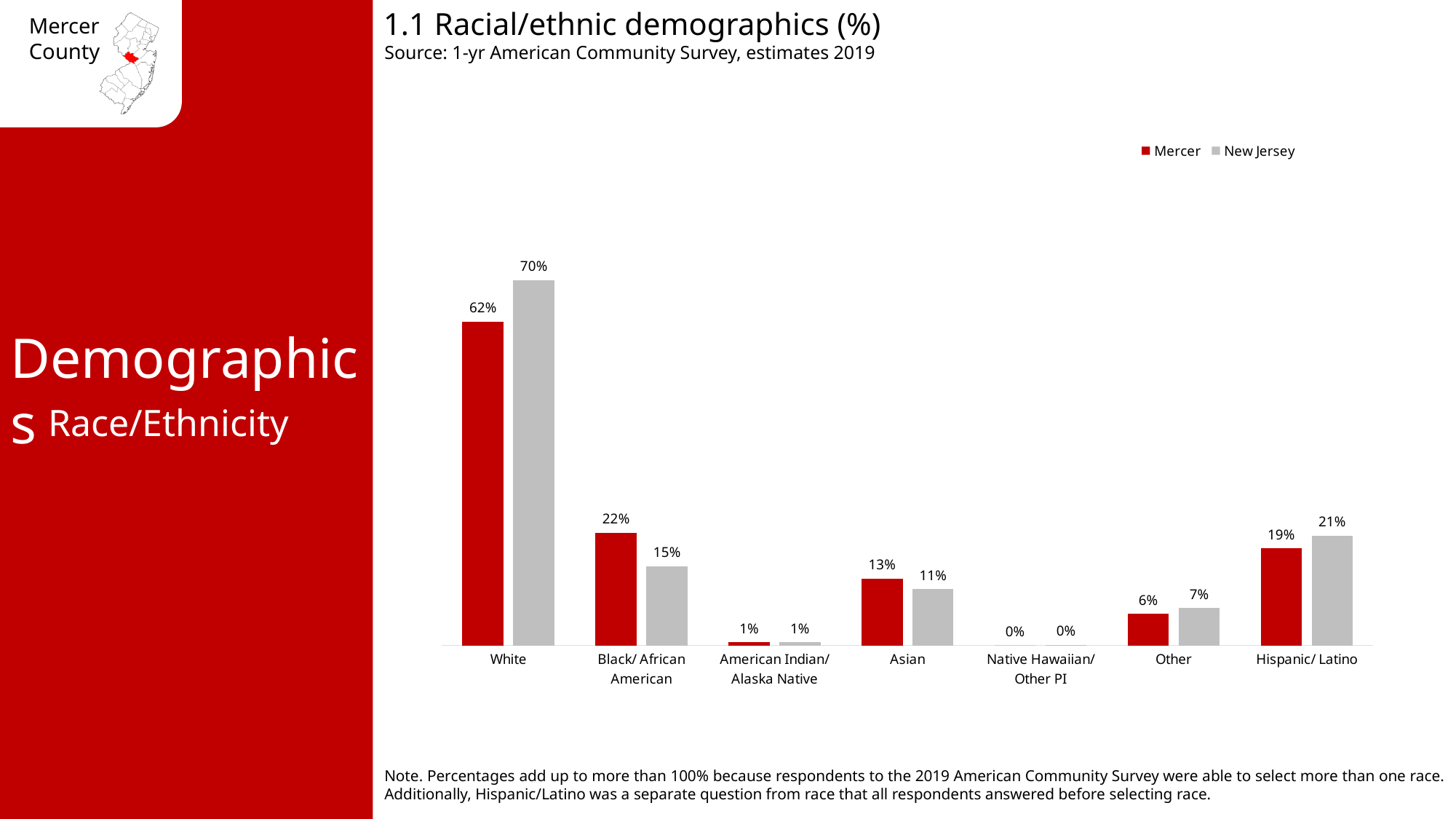
What is the New Jersey value for Black/ African American? 15% What is the difference between the Mercer and New Jersey values for Black/ African American? 7% What is the Mercer value for Hispanic/ Latino? 19% How many categories are shown on the x axis? 7 What kind of chart is shown on the slide? Bar chart What is the Mercer value for White? 62% What colour are the Mercer bars? Red What is the difference between the New Jersey and Mercer values for White? 8% Which is larger for Asian, the Mercer value or the New Jersey value? Mercer Which category has the lowest Mercer value? Native Hawaiian/ Other PI How many series does the legend list? 2 Which category has the highest New Jersey value? White